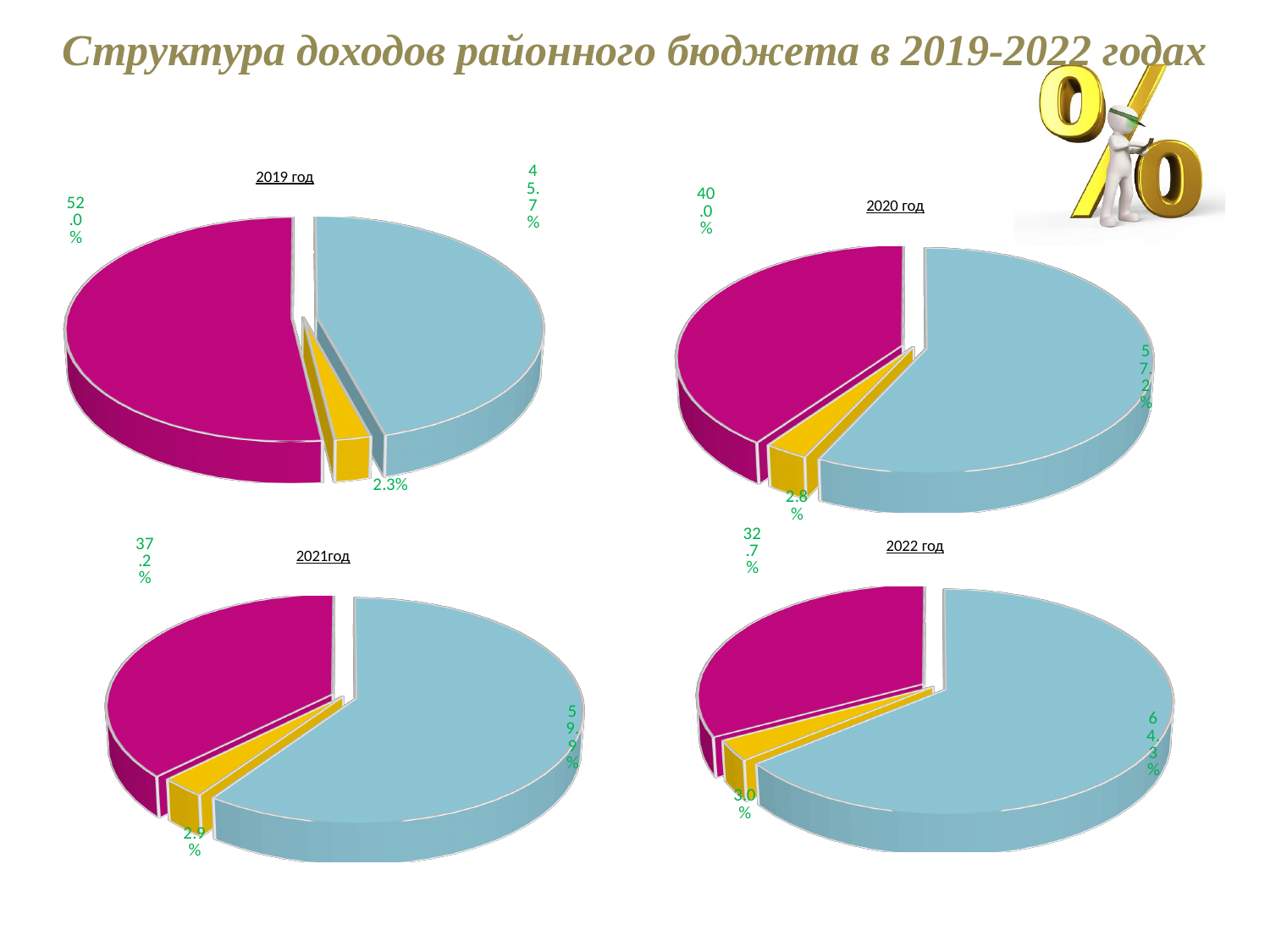
In the 2020 год pie chart, what share does the light blue slice represent? 57.2% How many pie charts are shown on the slide? 4 In the 2021год pie chart, what is the difference between the light blue slice and the magenta slice? 22.7% In the 2022 год pie chart, what share does the magenta slice represent? 32.7% In the 2021год pie chart, what share does the yellow slice represent? 2.9% In the 2020 год pie chart, which slice is the largest: magenta, light blue or yellow? light blue In the 2019 год pie chart, what share does the light blue slice represent? 45.7% In the 2019 год pie chart, what is the value of the smallest (yellow) slice? 2.3% In the 2022 год pie chart, which is larger, the magenta slice or the light blue slice? light blue What type of chart is used for each year on this slide? pie chart In the 2019 год pie chart, what share does the magenta slice represent? 52.0% How many slices does the 2022 год pie chart have? 3